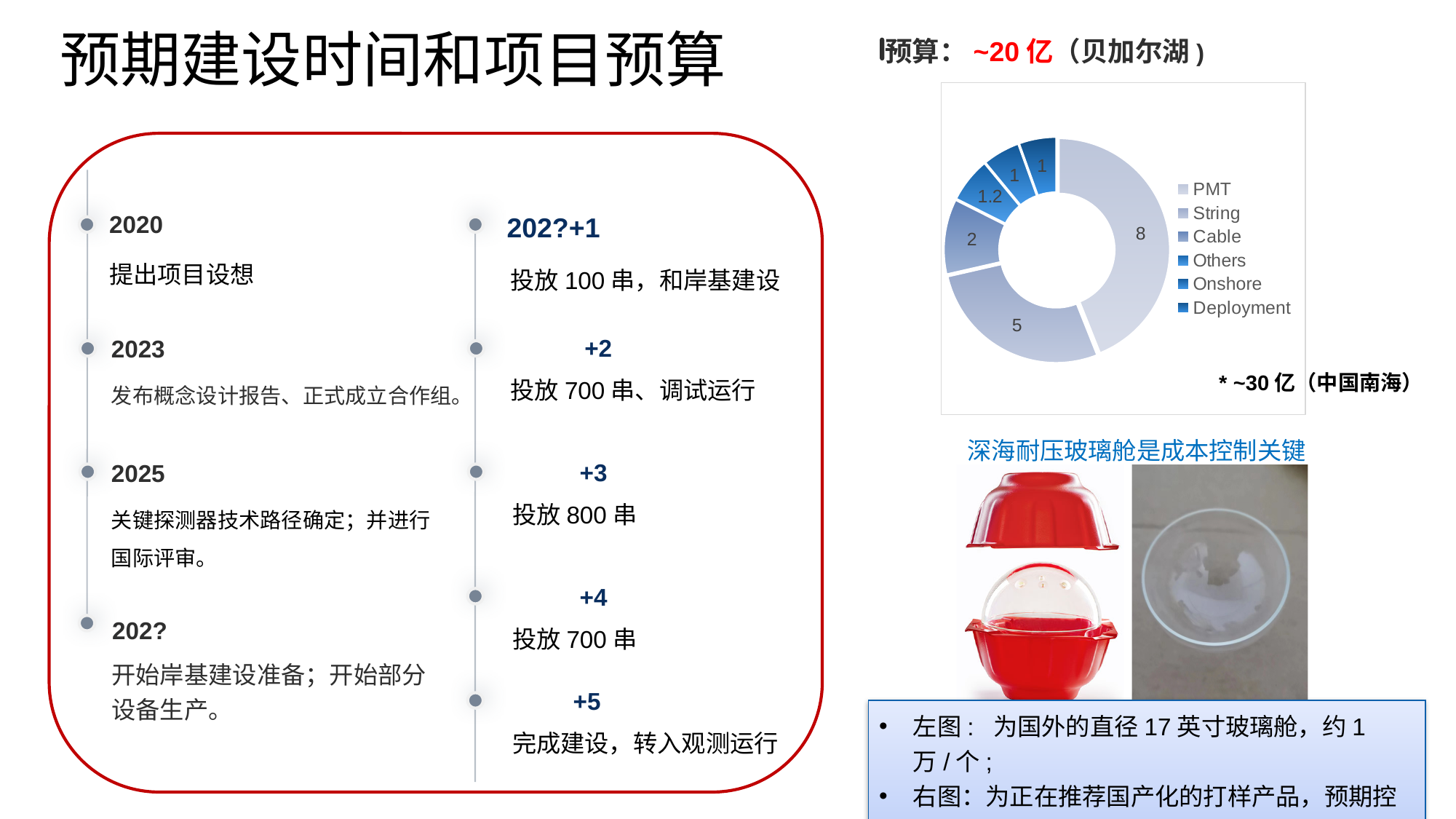
What is the total of all values shown in the doughnut chart? 18.2 How many categories does the legend of the doughnut chart list? 6 What is the value for PMT in the doughnut chart? 8 What is the value for Onshore in the doughnut chart? 1 Which is larger in the doughnut chart, Cable or Others? Cable What is the difference between the values for PMT and String in the doughnut chart? 3 What is the value for Cable in the doughnut chart? 2 What budget figure is stated in the heading above the doughnut chart? ~20 亿 What is the value for String in the doughnut chart? 5 Which category has the largest value in the doughnut chart? PMT What is the value for Others in the doughnut chart? 1.2 What kind of chart is shown on the right side of the slide? doughnut chart